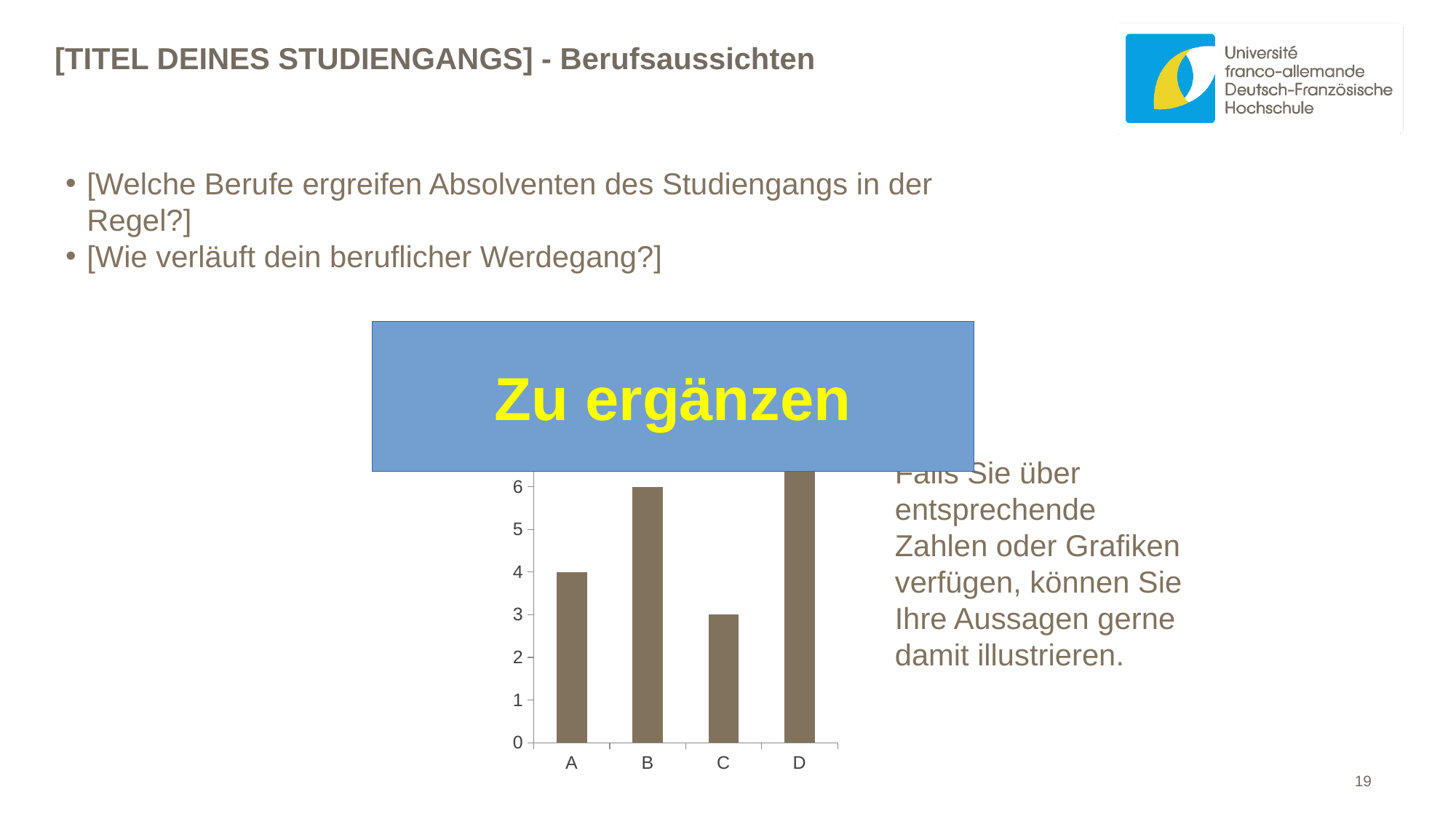
What is the value for category A? 4 Which category has the highest value? D What kind of chart is shown on the slide? bar chart What is the value for category C? 3 What is the value for category B? 6 What is the difference between the values for B and C? 3 How many categories are shown on the x axis of the chart? 4 Which category has the lowest value? C Is the value for C greater or less than 4? less Which is larger, the value for A or the value for C? A What is the difference between the values for B and A? 2 Is the value for D greater or less than 6? greater